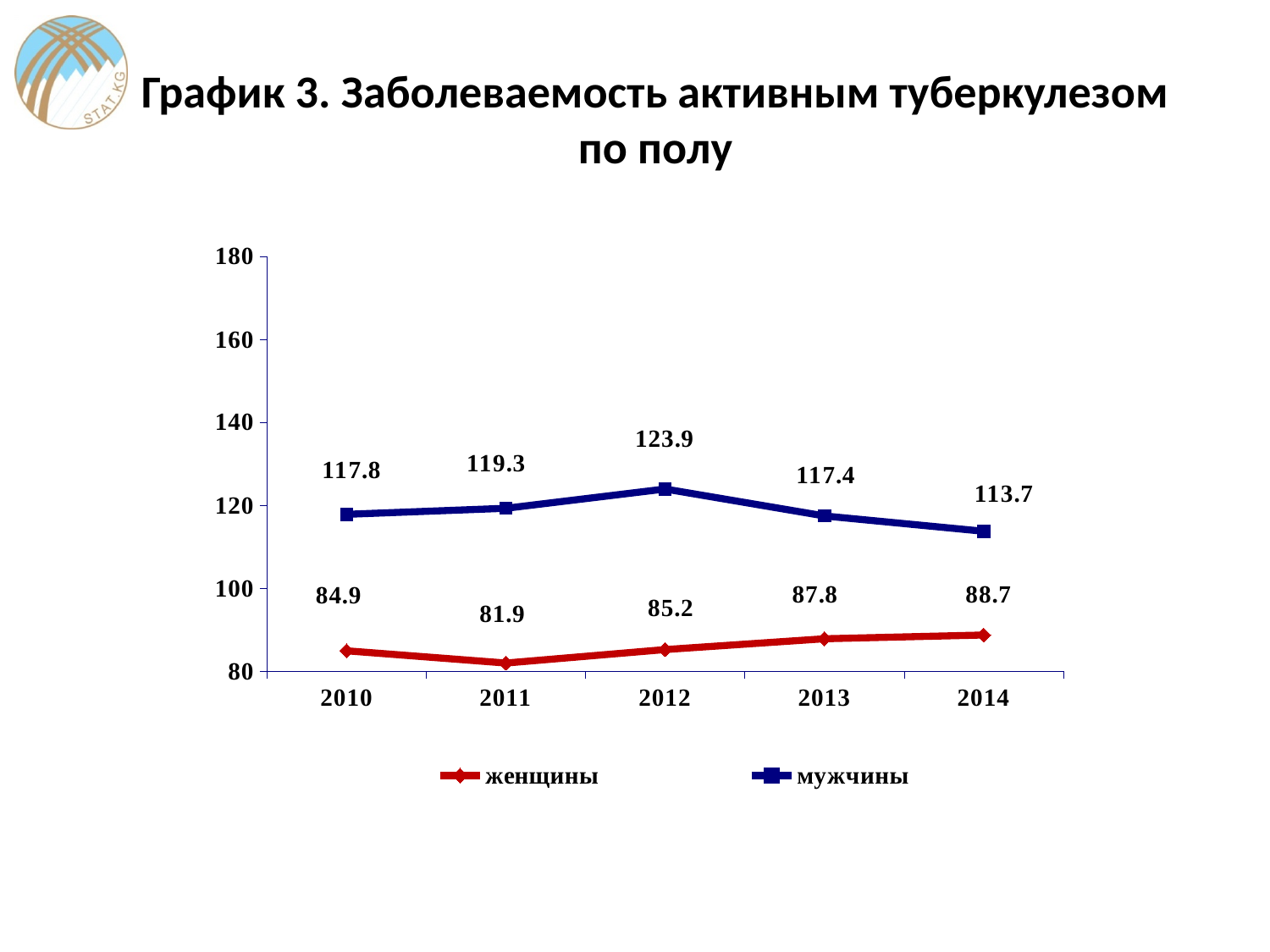
How many series does the legend list? 2 Which is larger in 2013: the value for мужчины or for женщины? мужчины What is the value for мужчины in 2012? 123.9 What kind of chart is shown? line chart Does the value for мужчины rise or fall from 2012 to 2014? fall What is the value for женщины in 2011? 81.9 What is the difference between the мужчины and женщины values in 2010? 32.9 How many years are shown on the x axis? 5 Is the value for мужчины in 2014 greater or less than 120? less In which year is the value for женщины lowest? 2011 What is the value for женщины in 2014? 88.7 In which year is the value for мужчины highest? 2012